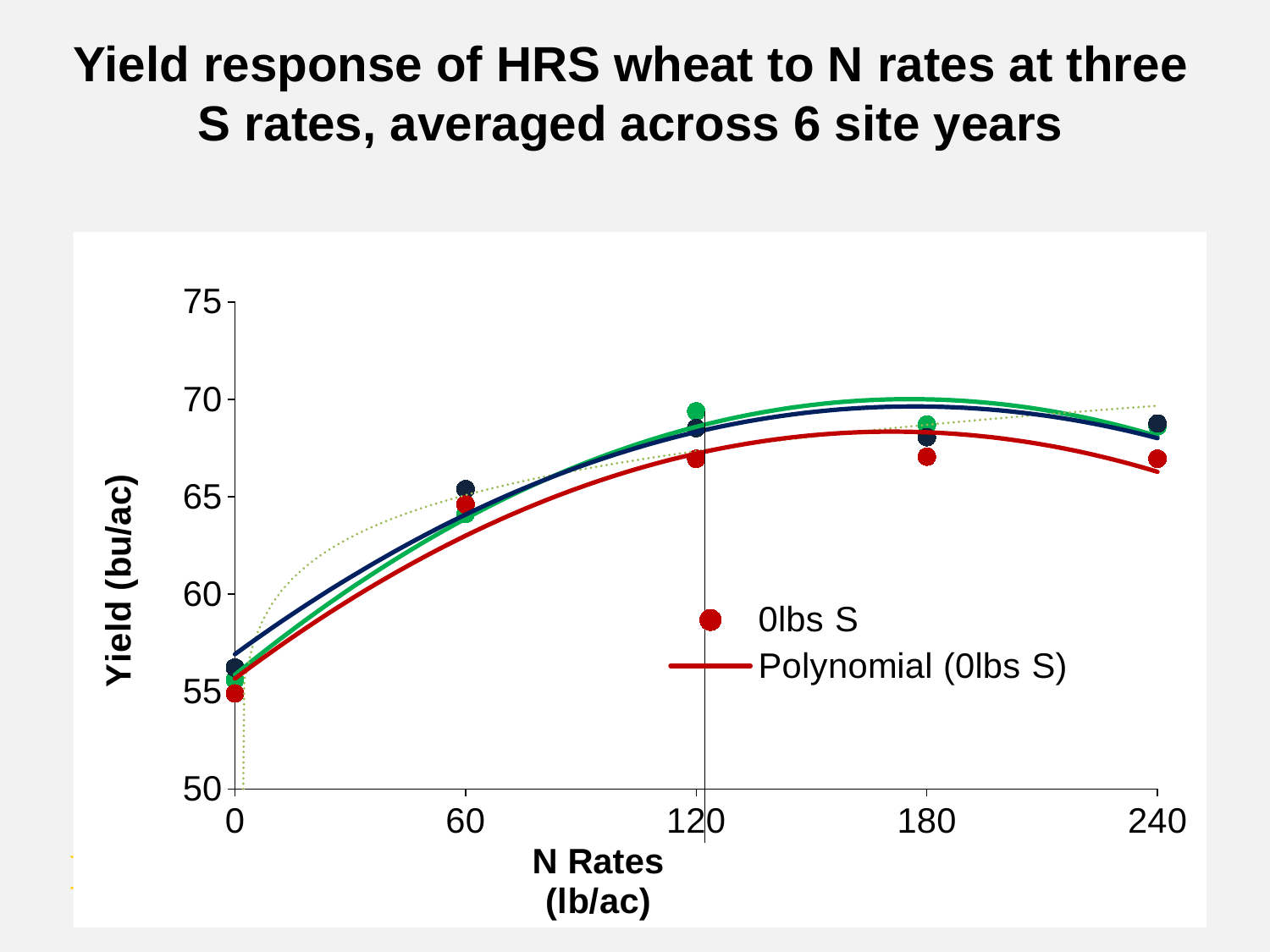
Is the yield for 0lbs S at an N rate of 60 greater or less than 60? greater Do the 0lbs S yields rise or fall as the N rate increases from 0 to 120? rise How many N rate points are plotted for the 0lbs S series? 5 Is the yield for 0lbs S at an N rate of 180 greater or less than 70? less Is the yield for 0lbs S at an N rate of 0 greater or less than 60? less What kind of chart is shown on the slide? Scatter chart How many entries does the legend list? 2 What is the title of the y axis? Yield (bu/ac) At which N rate is the yield for 0lbs S lowest? 0 For the 0lbs S series, is the yield higher at an N rate of 0 or at an N rate of 120? 120